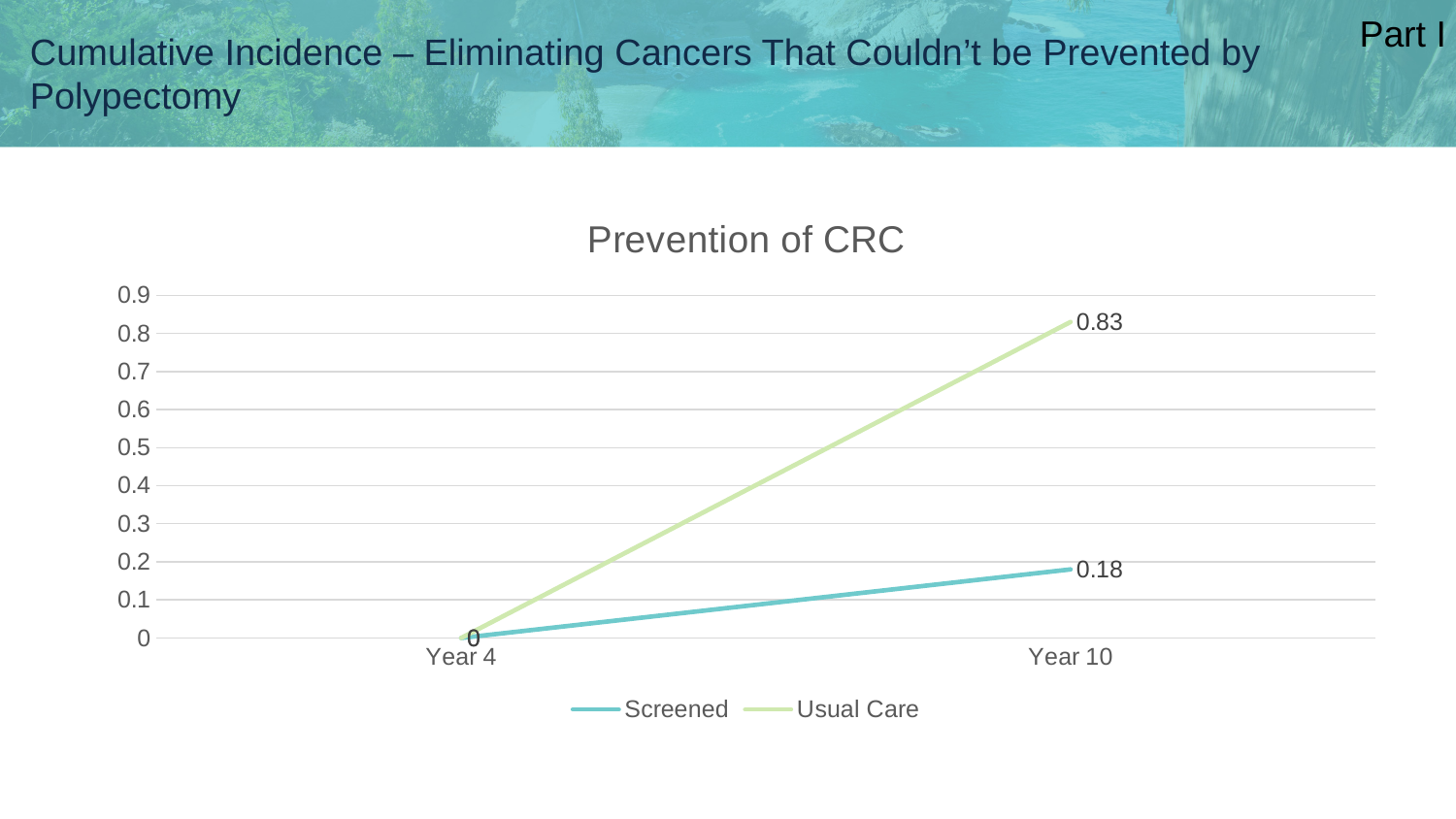
Do the values rise or fall from Year 4 to Year 10? Rise Which series has the higher value at Year 10, Screened or Usual Care? Usual Care What is the difference between the Usual Care and Screened values at Year 10? 0.65 What is the value for Screened at Year 10? 0.18 How many categories are shown on the x axis? 2 What is the value for Usual Care at Year 10? 0.83 How many series does the legend list? 2 What is the value at Year 4? 0 Is the value for Screened at Year 10 greater or less than 0.2? less What is the title of the chart? Prevention of CRC What kind of chart is shown? Line chart Is the value for Usual Care at Year 10 greater or less than 0.5? greater